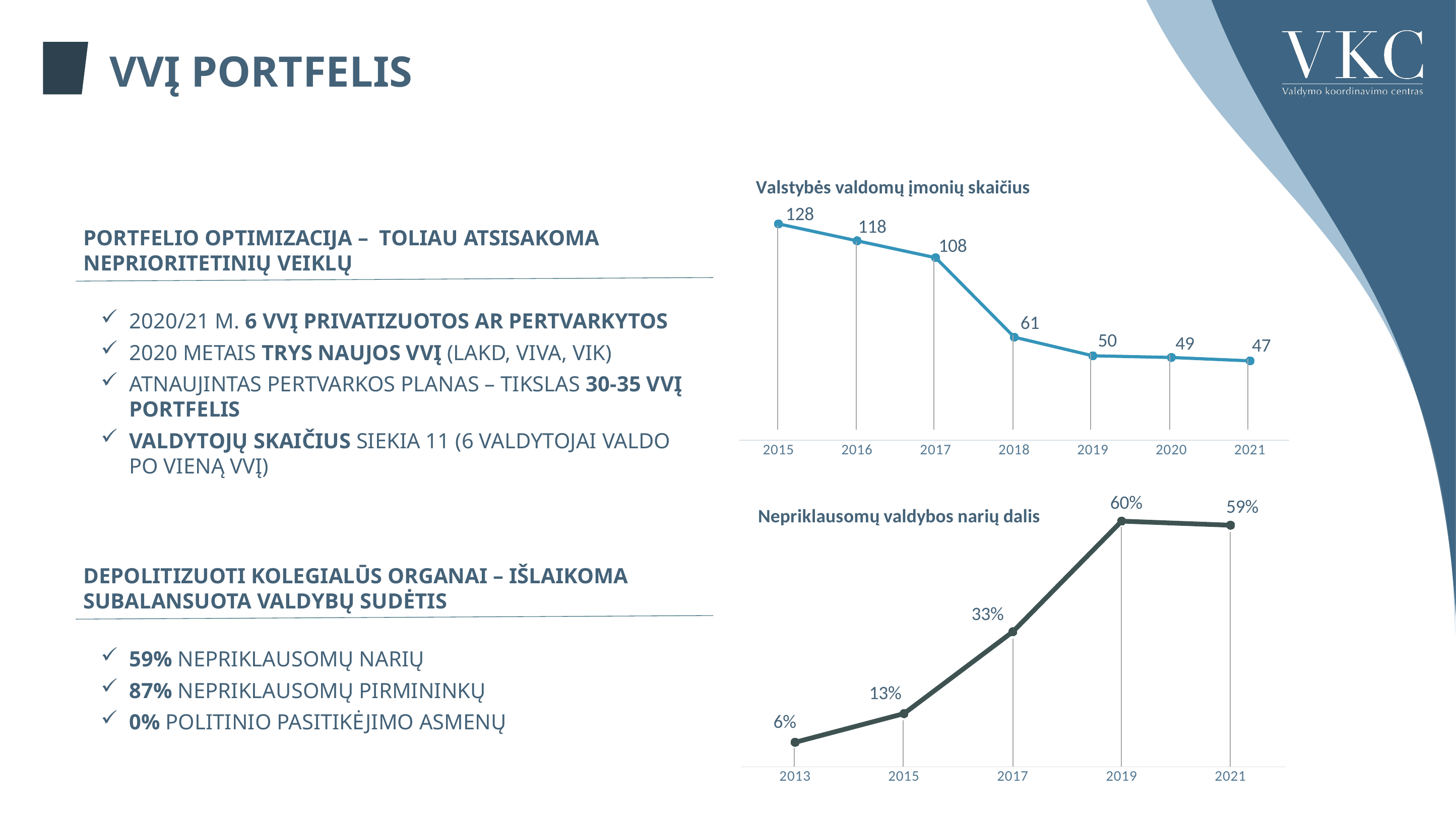
In the chart titled "Valstybės valdomų įmonių skaičius", what is the difference between the values for 2017 and 2018? 47 In the chart titled "Valstybės valdomų įmonių skaičius", which year has the lowest value? 2021 In the chart titled "Nepriklausomų valdybos narių dalis", what is the value for 2017? 33% In the chart titled "Nepriklausomų valdybos narių dalis", which is larger, the value for 2015 or the value for 2017? 2017 In the chart titled "Valstybės valdomų įmonių skaičius", what is the value for 2017? 108 What kind of chart is the chart titled "Valstybės valdomų įmonių skaičius"? line chart In the chart titled "Nepriklausomų valdybos narių dalis", what is the difference between the values for 2019 and 2013? 54% In the chart titled "Valstybės valdomų įmonių skaičius", which year has the highest value? 2015 In the chart titled "Valstybės valdomų įmonių skaičius", do the values rise or fall from 2015 to 2021? fall In the chart titled "Valstybės valdomų įmonių skaičius", how many years are plotted? 7 In the chart titled "Nepriklausomų valdybos narių dalis", which year has the highest value? 2019 In the chart titled "Nepriklausomų valdybos narių dalis", how many data points are plotted? 5